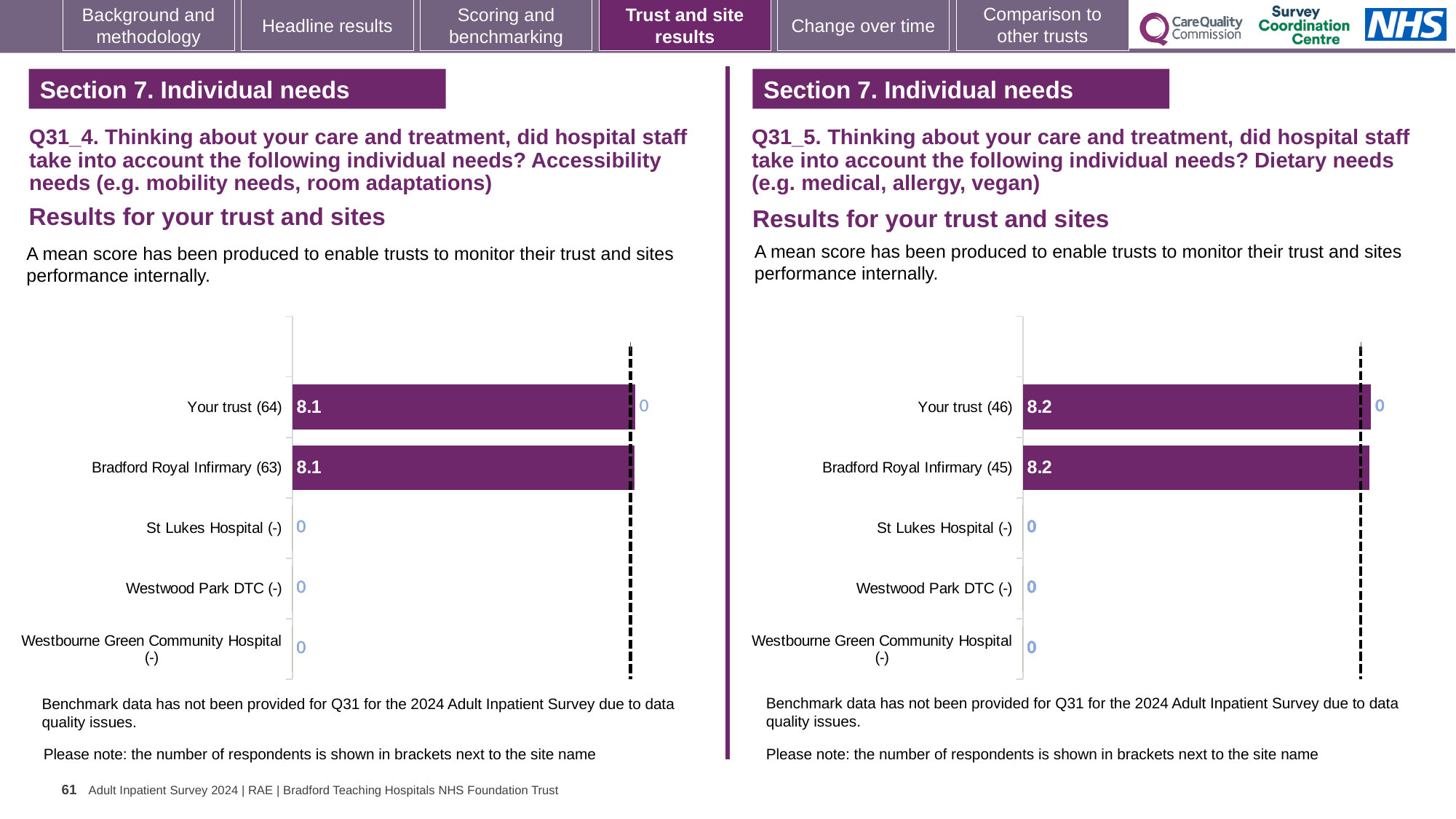
What kind of chart is used for the Q31_5 results on the right? Bar chart In the Q31_4 chart on the left, what value is shown for St Lukes Hospital? 0 Is the score for Your trust higher in the Q31_4 chart on the left or the Q31_5 chart on the right? Q31_5 chart on the right In the Q31_4 chart on the left, what is the mean score for Your trust? 8.1 In the Q31_4 chart on the left, what is the mean score for Bradford Royal Infirmary? 8.1 How many categories (sites) are listed in the Q31_4 chart on the left? 5 In the Q31_5 chart on the right, how many respondents are shown in brackets for Bradford Royal Infirmary? 45 In the Q31_4 chart on the left, what is the difference between the scores for Your trust and Bradford Royal Infirmary? 0 In the Q31_5 chart on the right, what value is shown for Westwood Park DTC? 0 In the Q31_5 chart on the right, what is the mean score for Your trust? 8.2 In the Q31_5 chart on the right, what is the mean score for Bradford Royal Infirmary? 8.2 In the Q31_4 chart on the left, how many respondents are shown in brackets for Your trust? 64